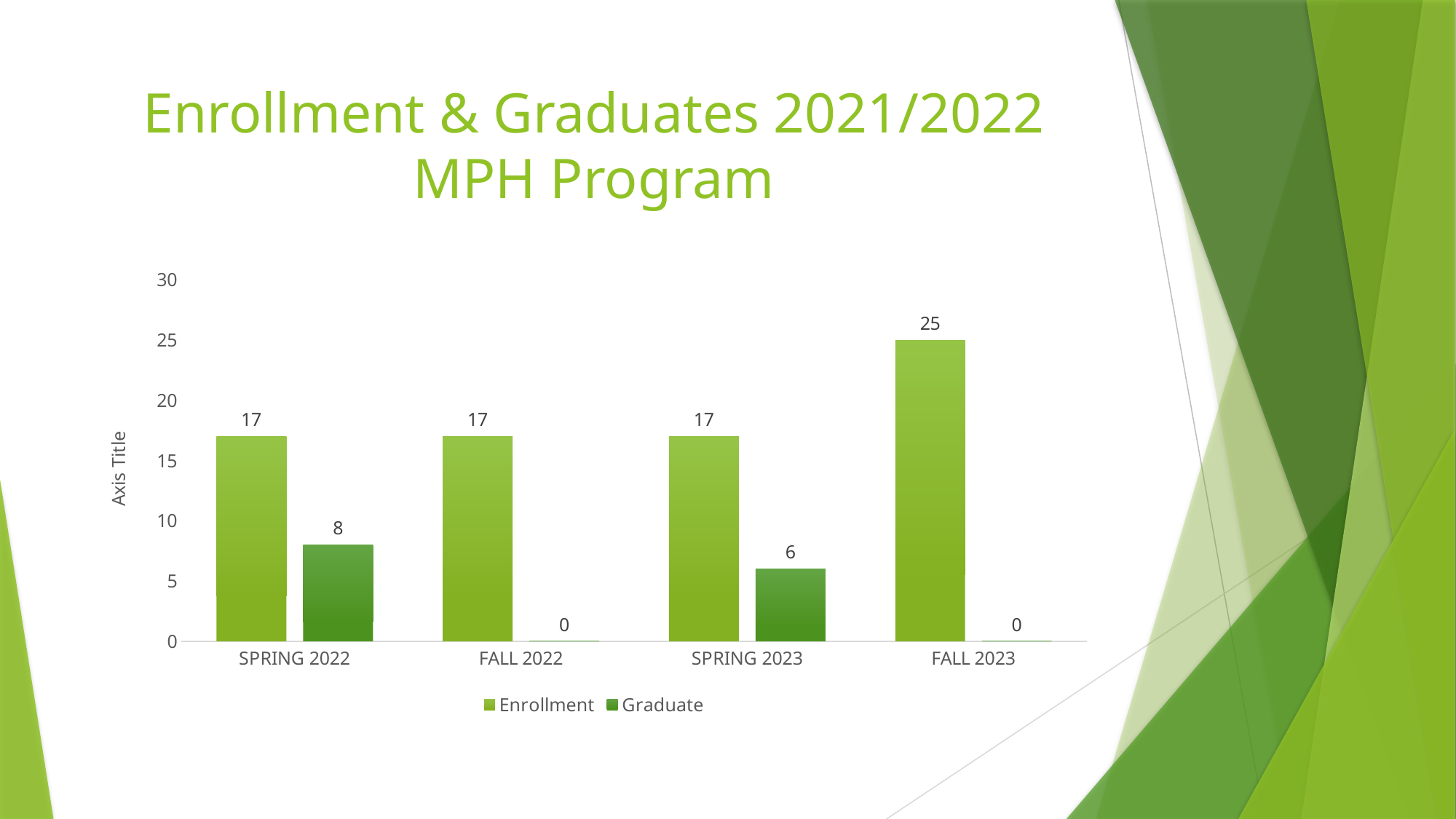
Which period has the highest Enrollment value? FALL 2023 What is the difference between the Enrollment values for FALL 2023 and FALL 2022? 8 Which is larger, the Graduate value for SPRING 2022 or for SPRING 2023? SPRING 2022 How many periods are shown on the x axis? 4 Which period has the highest Graduate value? SPRING 2022 What is the difference between Enrollment and Graduate for SPRING 2023? 11 What kind of chart is shown on the slide? Bar chart What is the Graduate value for SPRING 2022? 8 What is the Enrollment value for SPRING 2022? 17 How many series does the legend list? 2 What is the Graduate value for SPRING 2023? 6 What is the Enrollment value for FALL 2023? 25